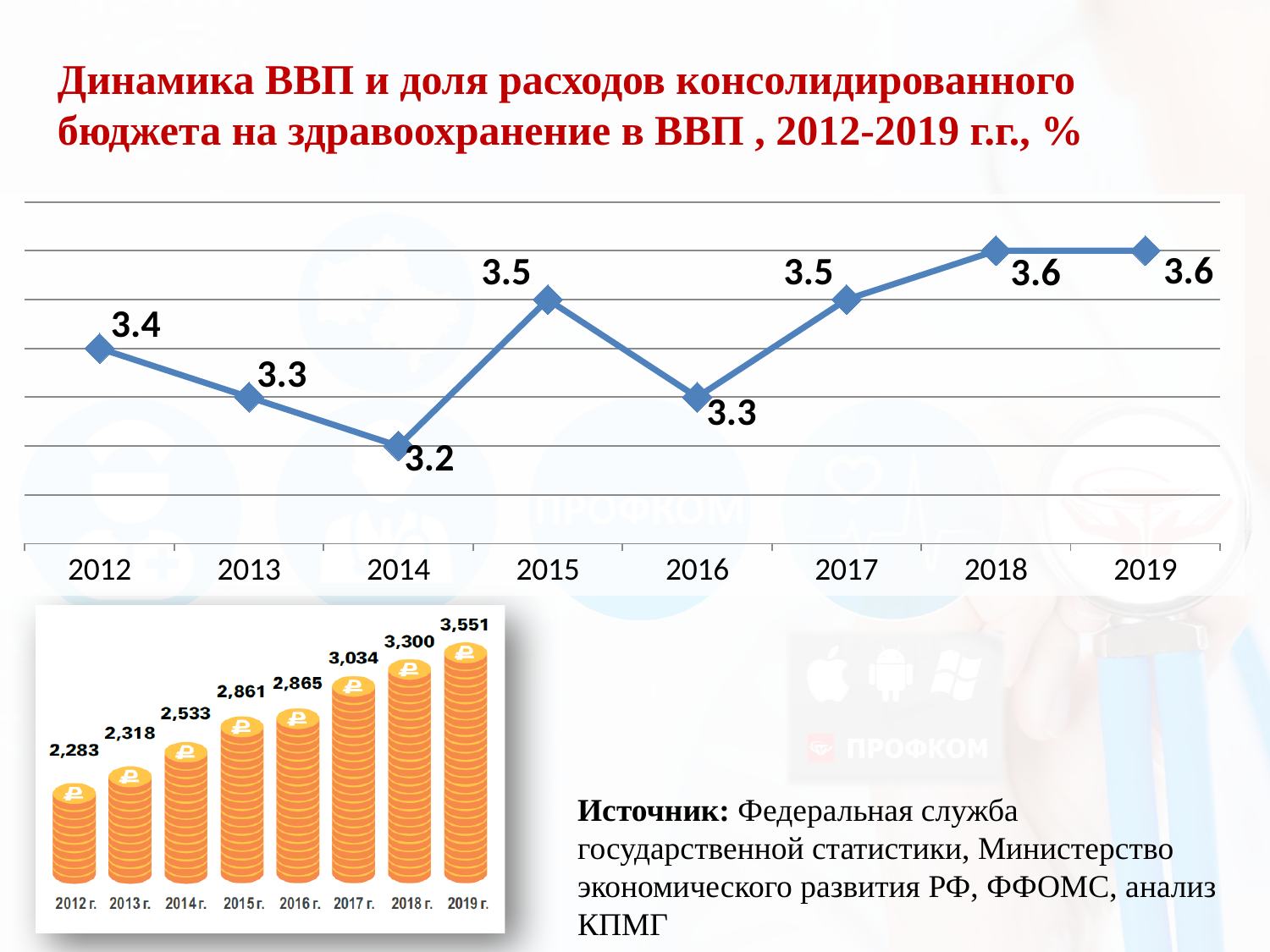
In the bar chart at the bottom left of the slide, which year has the highest value? 2019 г. In the bar chart at the bottom left of the slide, what is the value for 2017 г.? 3,034 In the line chart at the top of the slide, what is the value for 2014? 3.2 In the line chart at the top of the slide, what is the value for 2017? 3.5 What kind of chart is the chart at the bottom left of the slide? bar chart In the bar chart at the bottom left of the slide, what is the difference between the values for 2019 г. and 2012 г.? 1,268 In the line chart at the top of the slide, which is larger, the value for 2015 or the value for 2016? 2015 In the line chart at the top of the slide, do the values rise or fall from 2016 to 2018? rise In the line chart at the top of the slide, what is the difference between the values for 2019 and 2014? 0.4 In the line chart at the top of the slide, which year has the lowest value? 2014 In the bar chart at the bottom left of the slide, do the values rise or fall from 2012 г. to 2019 г.? rise How many data points are plotted in the line chart at the top of the slide? 8